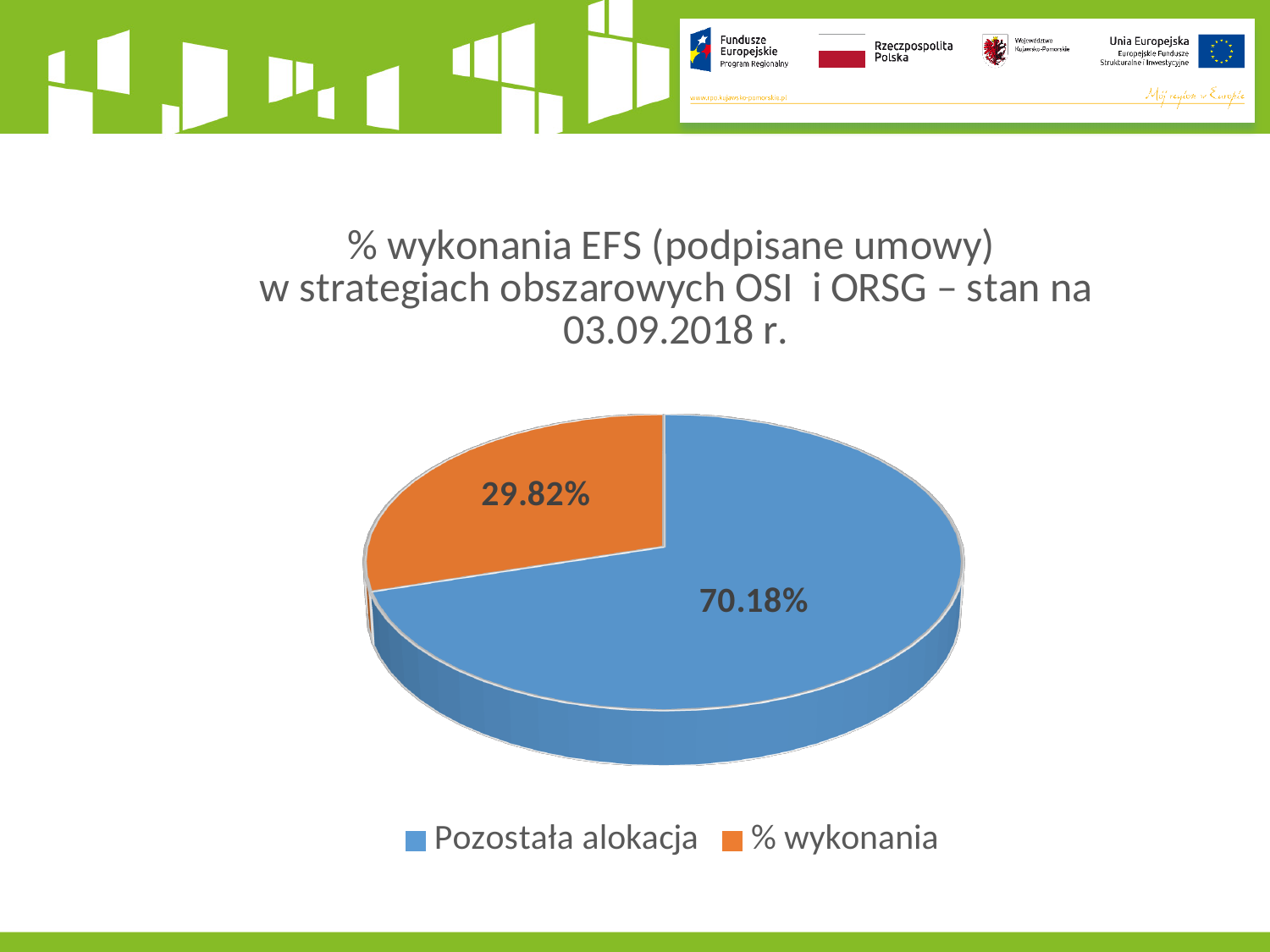
Which slice is the largest? Pozostała alokacja What is the difference between the "Pozostała alokacja" and "% wykonania" slices? 40.36% Which slice is the smallest? % wykonania What kind of chart is shown on the slide? Pie chart What is the value for "% wykonania"? 29.82% How many entries does the legend list? 2 How many slices does the pie chart have? 2 What date is given in the chart title as the status date? 03.09.2018 r. Which is larger, "Pozostała alokacja" or "% wykonania"? Pozostała alokacja What share of the pie does "% wykonania" represent? 29.82% What is the value for "Pozostała alokacja"? 70.18% What colour is the "Pozostała alokacja" slice? Blue